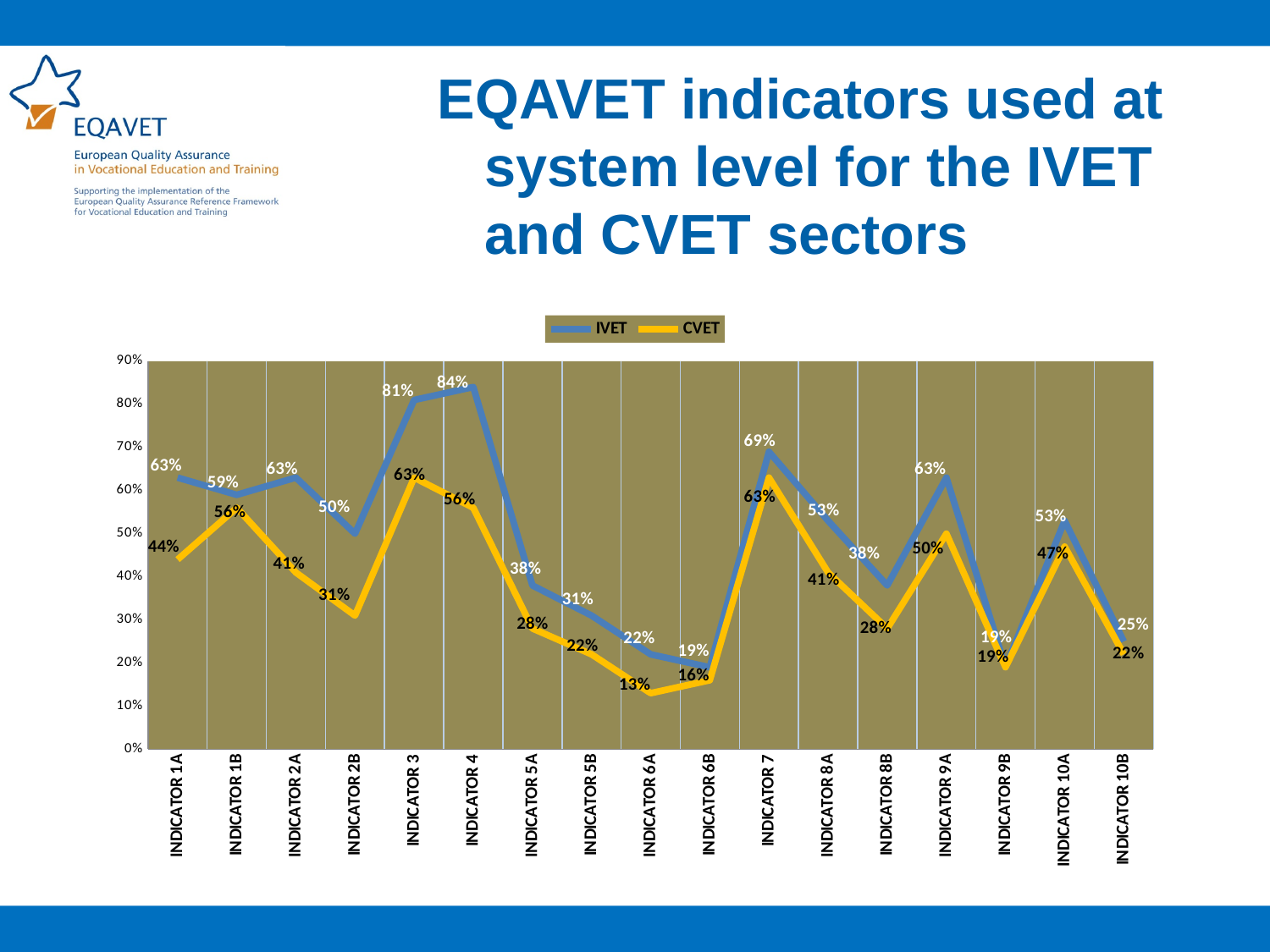
What is the IVET value for Indicator 4? 84% What is the difference between the IVET and CVET values for Indicator 3? 18% Which indicator has the highest IVET value? Indicator 4 How many series does the legend list? 2 What is the IVET value for Indicator 7? 69% What is the CVET value for Indicator 2B? 31% What kind of chart is shown on the slide? Line chart What is the CVET value for Indicator 6A? 13% Which is larger for Indicator 1A, the IVET value or the CVET value? IVET Which indicator has the lowest CVET value? Indicator 6A Which colour represents the CVET series? Yellow How many indicators are shown on the x axis? 17